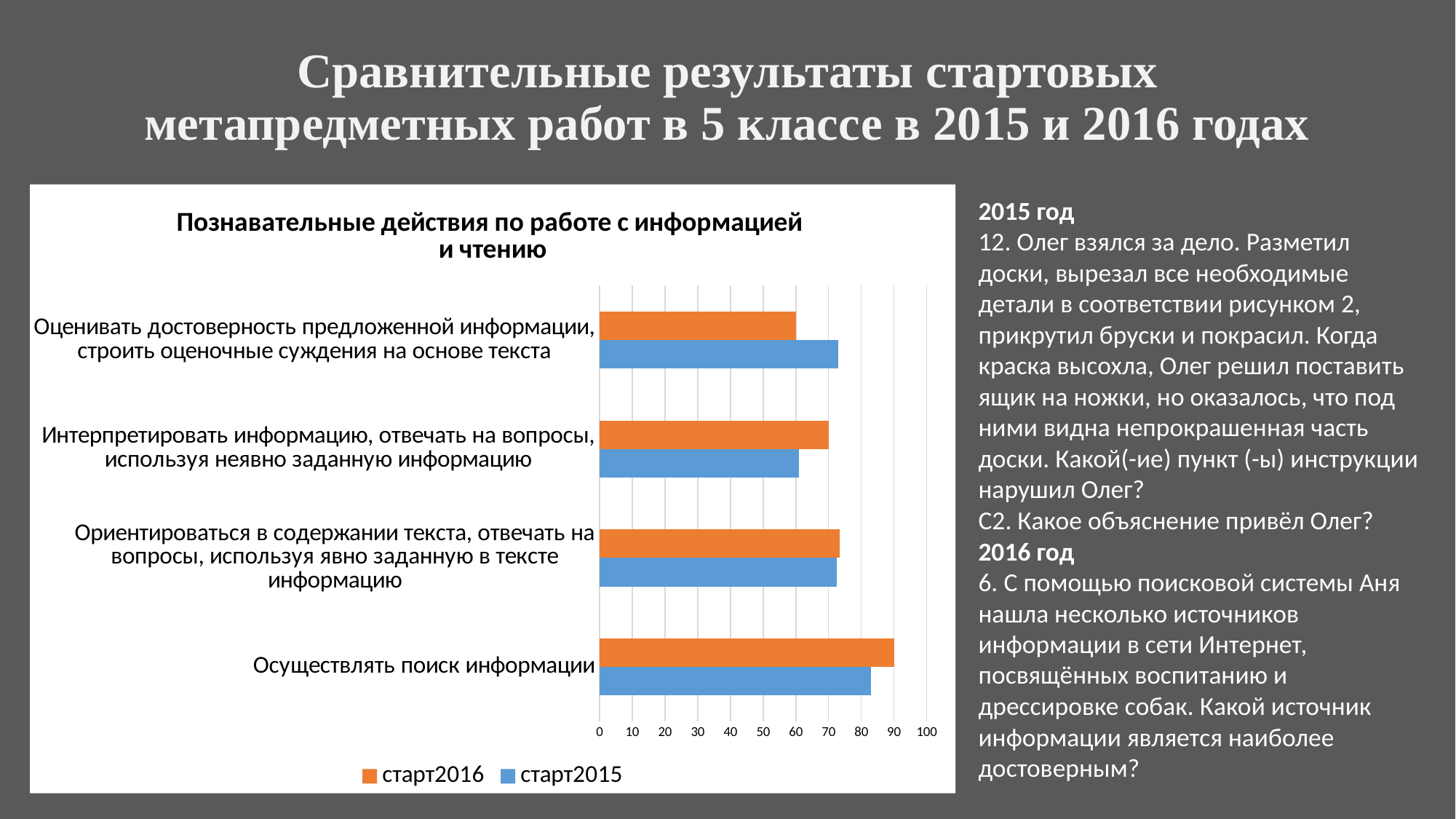
Is the старт2016 value for 'Оценивать достоверность предложенной информации, строить оценочные суждения на основе текста' greater or less than 70? less Is the старт2016 value for 'Осуществлять поиск информации' greater or less than 80? greater How many categories are plotted on the chart? 4 Which category has the highest value for старт2016? Осуществлять поиск информации What is the title of the chart? Познавательные действия по работе с информацией и чтению Which category has the lowest value for старт2015? Интерпретировать информацию, отвечать на вопросы, используя неявно заданную информацию How many series does the legend list? 2 Which category has the highest value for старт2015? Осуществлять поиск информации For 'Оценивать достоверность предложенной информации, строить оценочные суждения на основе текста', which series has the larger value, старт2016 or старт2015? старт2015 For 'Интерпретировать информацию, отвечать на вопросы, используя неявно заданную информацию', which series has the larger value, старт2016 or старт2015? старт2016 What kind of chart is shown on the slide? bar chart Which category has the lowest value for старт2016? Оценивать достоверность предложенной информации, строить оценочные суждения на основе текста